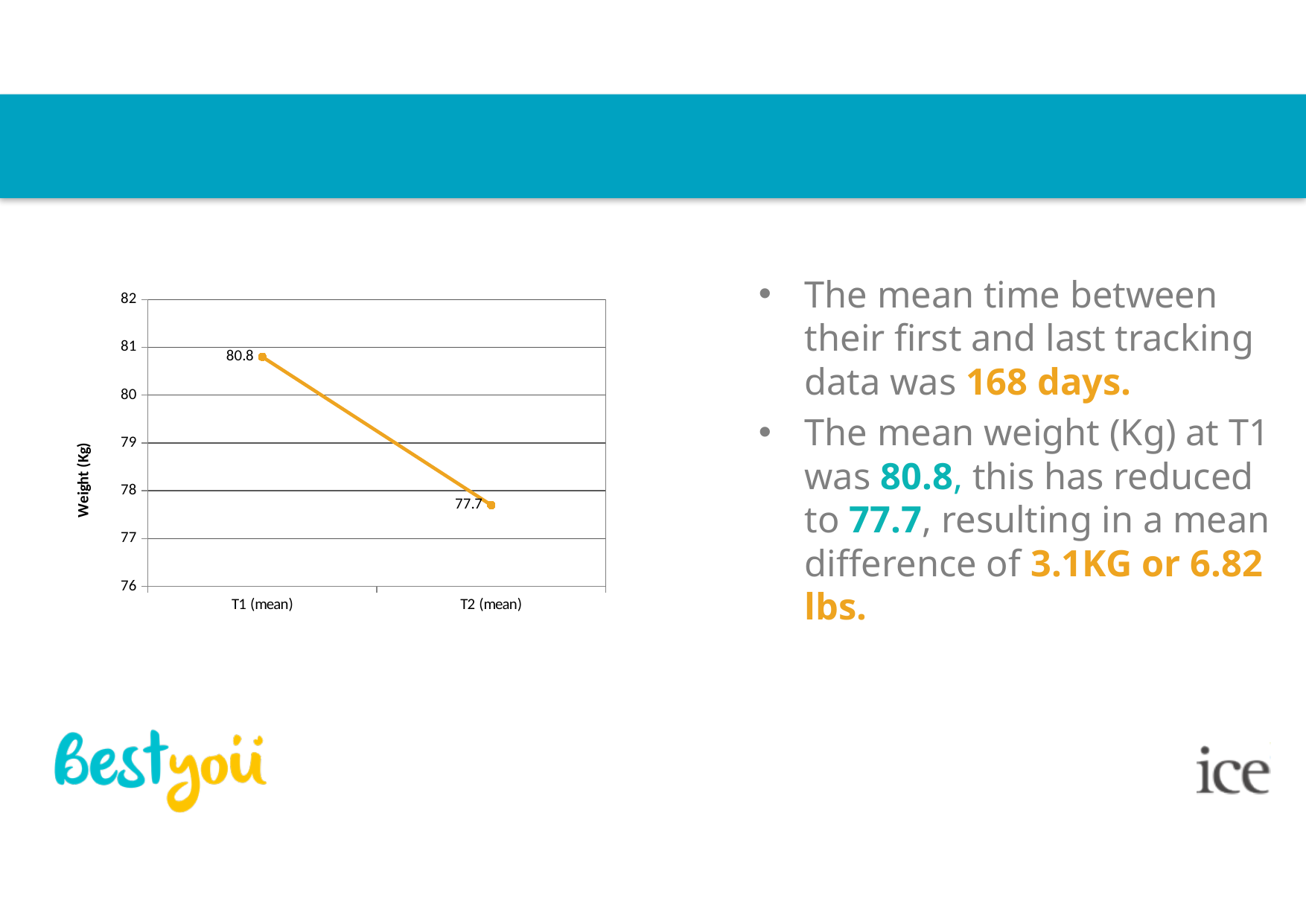
What is the value for T1 (mean) on the chart? 80.8 Which category has the highest value on the chart? T1 (mean) What kind of chart is shown on the slide? line chart What is the value for T2 (mean) on the chart? 77.7 What is the difference between the values for T1 (mean) and T2 (mean)? 3.1 Is the value for T2 (mean) greater or less than 78? less Do the values rise or fall from T1 (mean) to T2 (mean)? fall Is the value for T1 (mean) greater or less than 80? greater Which is larger, the value for T1 (mean) or T2 (mean)? T1 (mean) Which category has the lowest value on the chart? T2 (mean) How many categories are plotted on the x axis of the chart? 2 What is the label of the vertical axis of the chart? Weight (Kg)